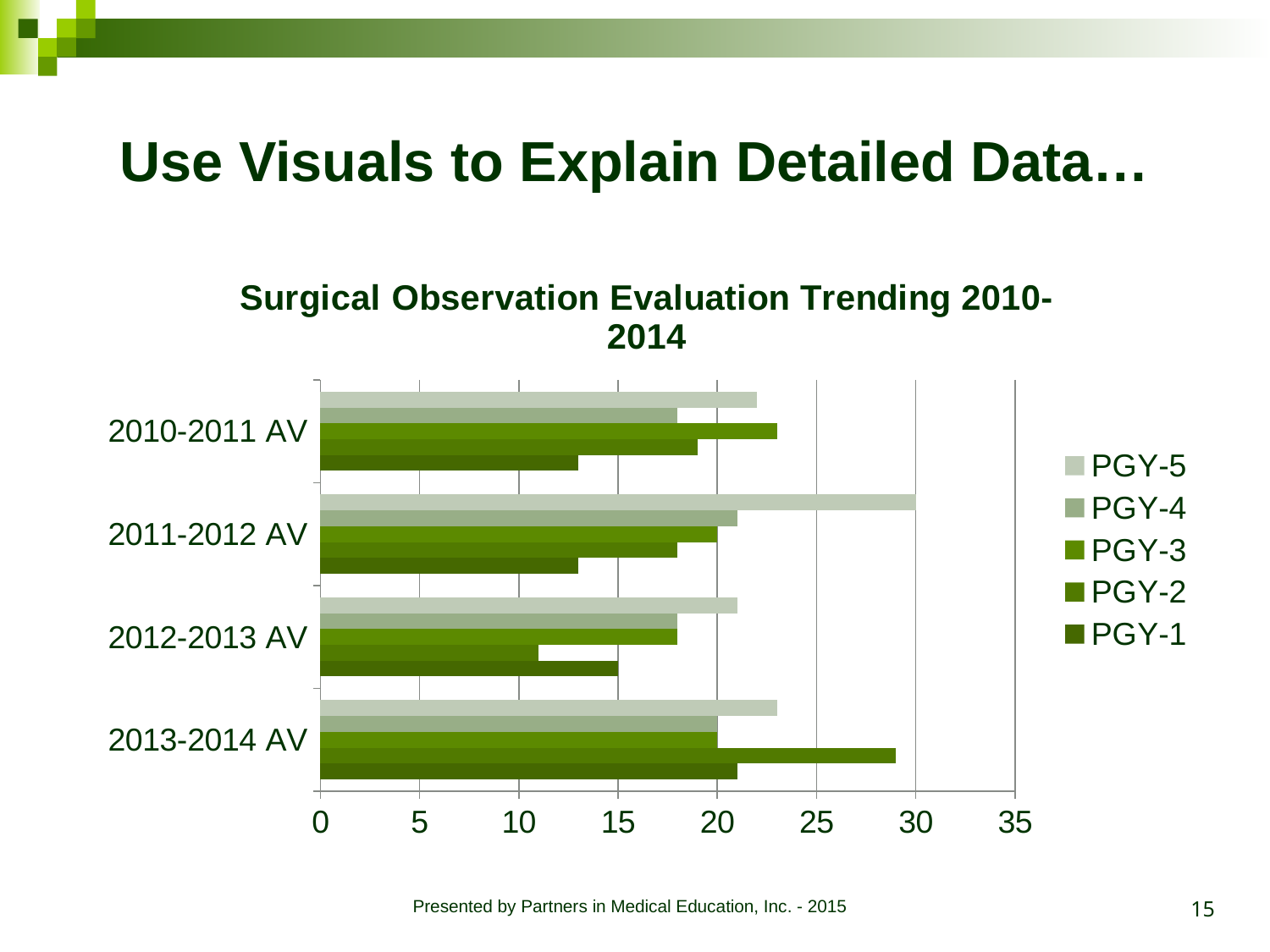
What is the title of the chart? Surgical Observation Evaluation Trending 2010-2014 Which academic year has the lowest PGY-2 value? 2012-2013 AV Which academic year has the highest PGY-5 value? 2011-2012 AV Is the PGY-2 value for 2013-2014 AV greater or less than 25? greater Is the PGY-1 value for 2010-2011 AV greater or less than 15? less What is the PGY-5 value for 2011-2012 AV? 30 How many series does the legend list? 5 Is the PGY-5 value for 2011-2012 AV greater or less than 25? greater For 2013-2014 AV, which is larger, the PGY-2 value or the PGY-1 value? PGY-2 What kind of chart is shown on the slide? bar chart How many academic-year categories are plotted on the y axis? 4